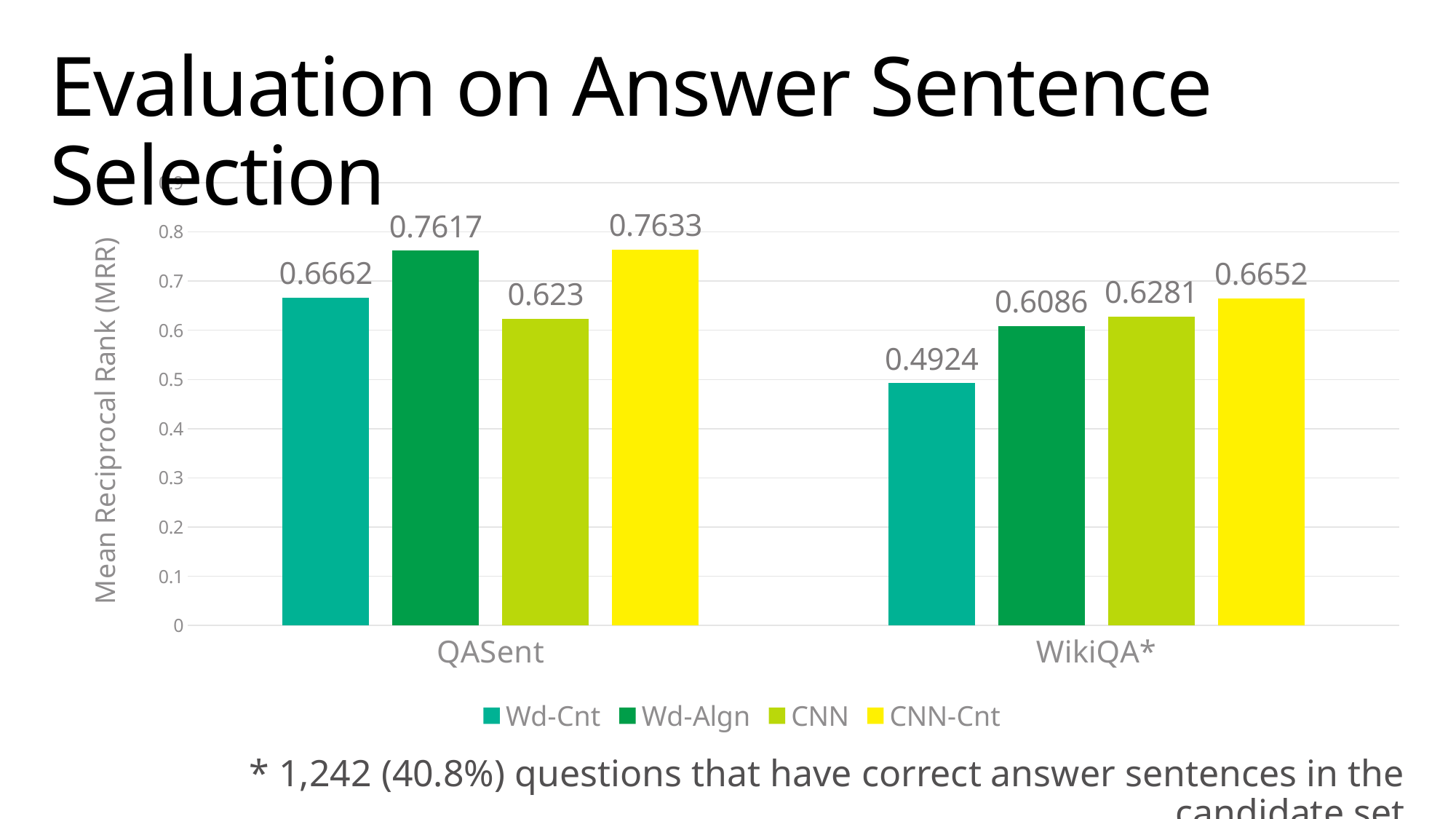
Which series has the lowest value on QASent? CNN How many series does the legend list? 4 Which series has the highest value on WikiQA*? CNN-Cnt What is the value for CNN-Cnt on WikiQA*? 0.6652 What kind of chart is shown on the slide? Bar chart What is the difference between the Wd-Cnt values for QASent and WikiQA*? 0.1738 What is the value for CNN on QASent? 0.623 What is the Mean Reciprocal Rank for Wd-Algn on QASent? 0.7617 Which is larger: CNN on WikiQA* or Wd-Algn on WikiQA*? CNN on WikiQA* What is the value for Wd-Cnt on WikiQA*? 0.4924 What is the label of the vertical axis? Mean Reciprocal Rank (MRR) Which series has the lowest value on WikiQA*? Wd-Cnt